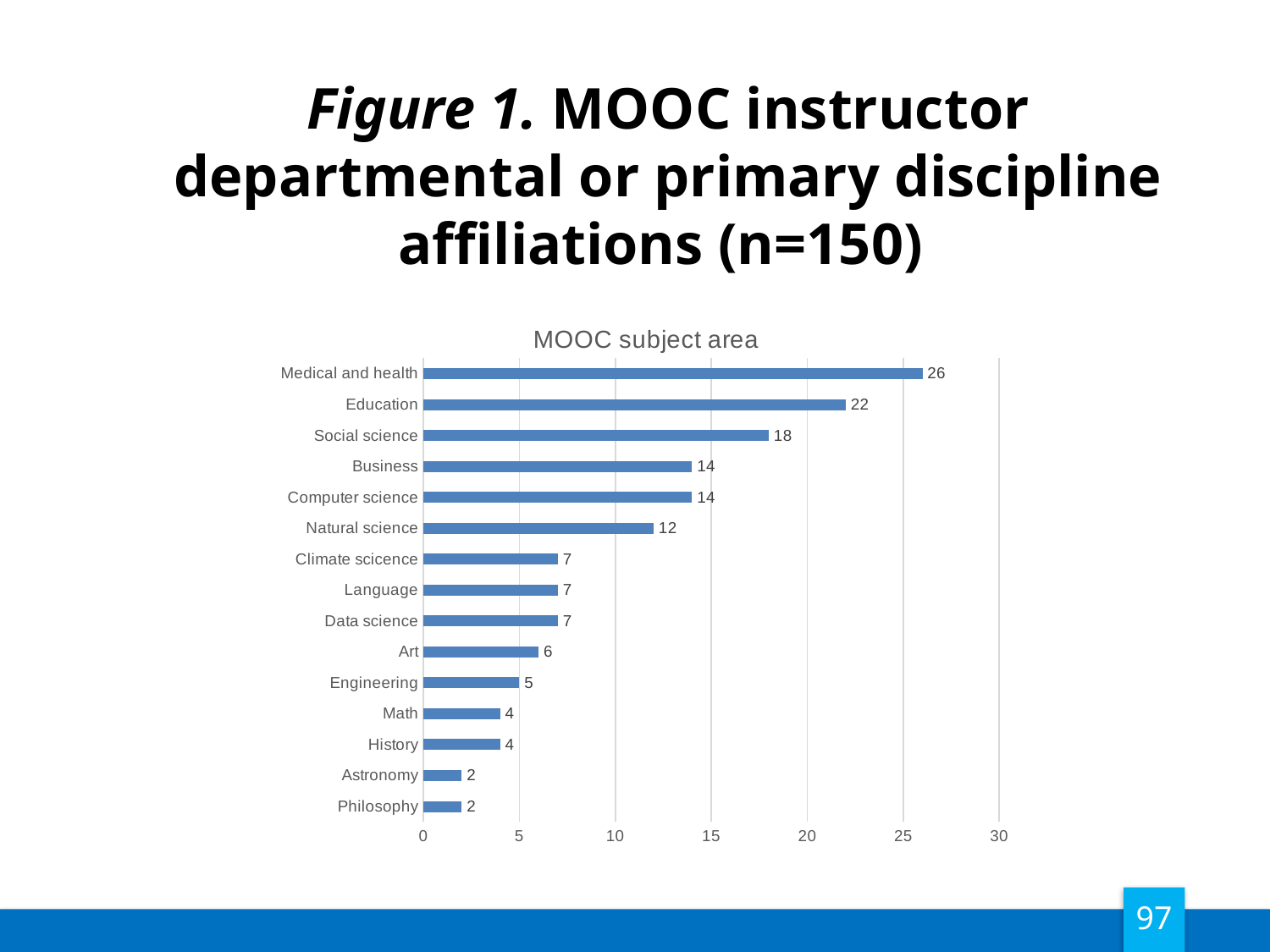
What is the value for Data science? 7 What is the value for Natural science? 12 What is the value for Engineering? 5 Which is larger, the value for Business or the value for Art? Business What is the difference between the values for Medical and health and Philosophy? 24 Which subject area has the highest value? Medical and health What is the title of the chart? MOOC subject area What is the value for Medical and health? 26 What is the difference between the values for Education and Social science? 4 Is the value for Education greater or less than 20? greater How many subject areas are shown in the chart? 15 What kind of chart is shown on the slide? Bar chart